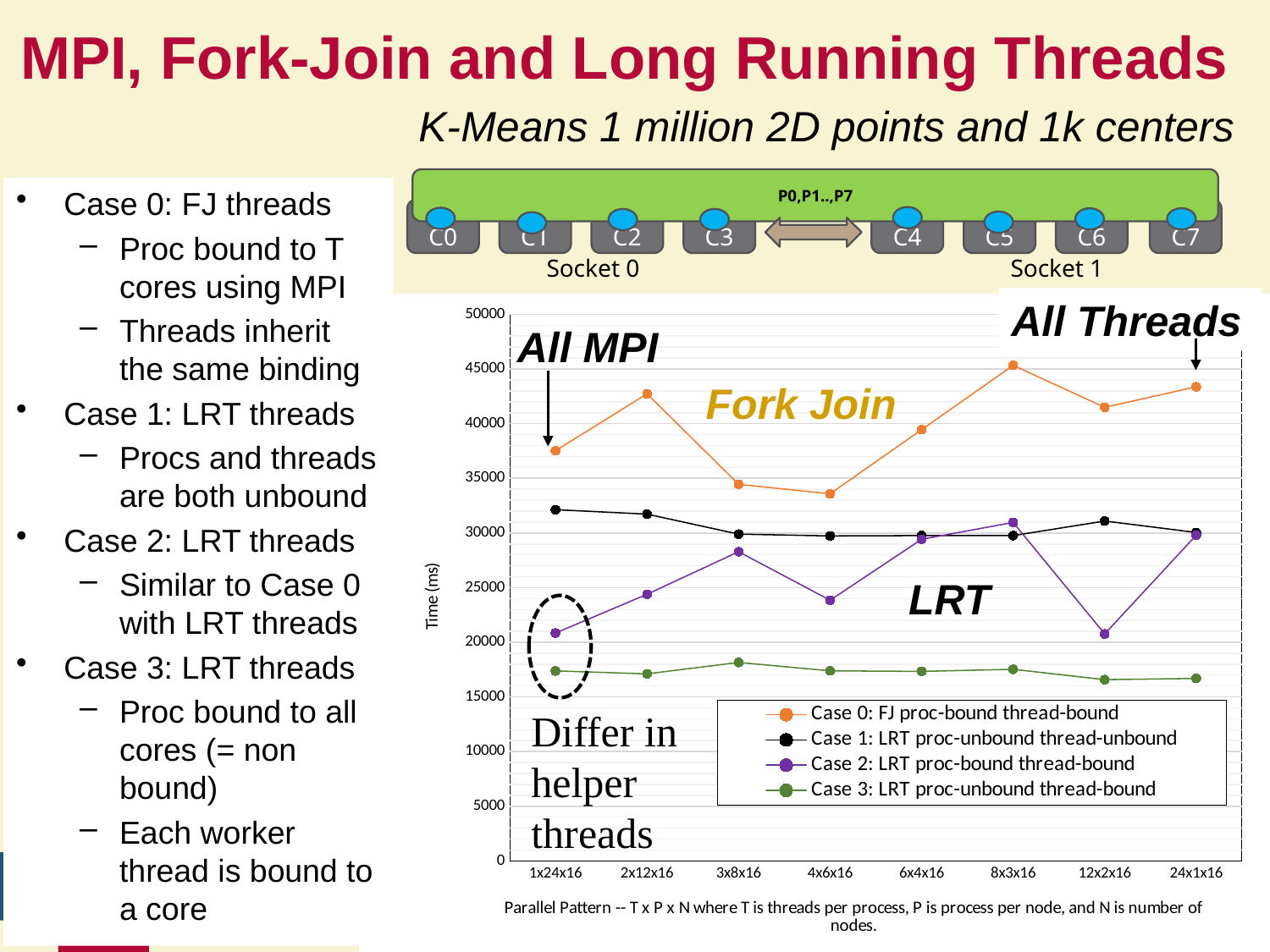
Is the value for Case 3 at 1x24x16 greater or less than 20000? less At which parallel pattern does Case 0 reach its highest time? 8x3x16 What kind of chart is shown on the slide? line chart At 1x24x16, which is larger: the value for Case 1 or the value for Case 2? Case 1 Is the value for Case 0 at 8x3x16 greater or less than 40000? greater How many series does the chart legend list? 4 Is the value for Case 1 at 1x24x16 greater or less than 30000? greater What is the label on the y axis of the chart? Time (ms) How many parallel pattern categories are shown on the x axis? 8 Does the Case 0 line rise or fall from 4x6x16 to 8x3x16? rise Which series has the lowest times across all parallel patterns? Case 3: LRT proc-unbound thread-bound